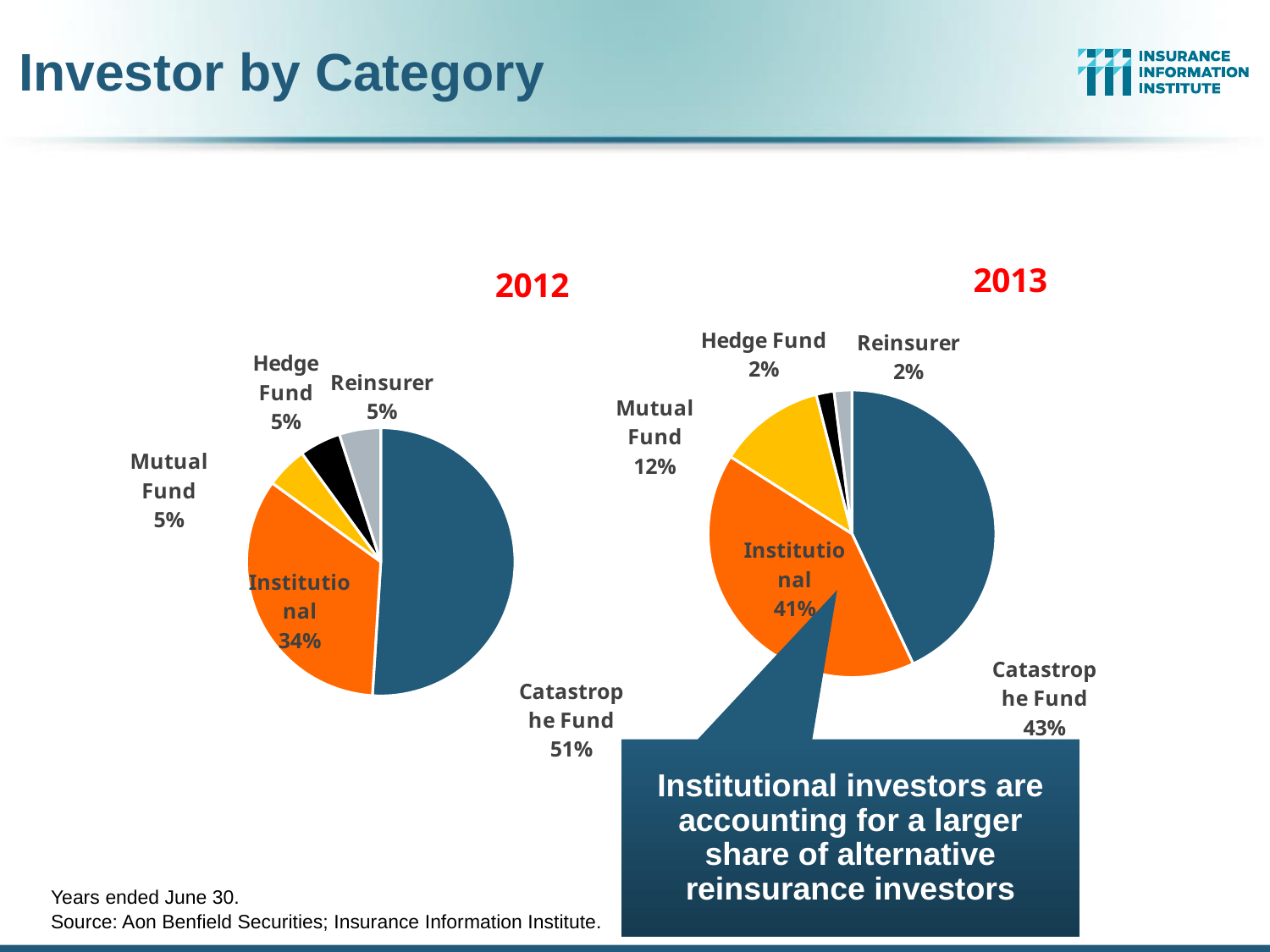
In the 2012 pie chart, what is the value for Institutional? 34% In the 2012 pie chart, which category has the largest share? Catastrophe Fund In the 2012 pie chart, what is the difference between the Catastrophe Fund share and the Institutional share? 17% What kind of chart is used to show the 2012 investor breakdown? Pie chart Is the Institutional share larger in the 2012 pie chart or the 2013 pie chart? 2013 In the 2013 pie chart, what share does the Institutional slice have? 41% In the 2013 pie chart, what is the value for Mutual Fund? 12% In the 2013 pie chart, what is the difference between the Catastrophe Fund share and the Institutional share? 2% How many categories are shown in the 2013 pie chart? 5 In the 2012 pie chart, what share does the Catastrophe Fund slice have? 51% In the 2013 pie chart, which category has the largest share? Catastrophe Fund In the 2013 pie chart, what is the value for Hedge Fund? 2%